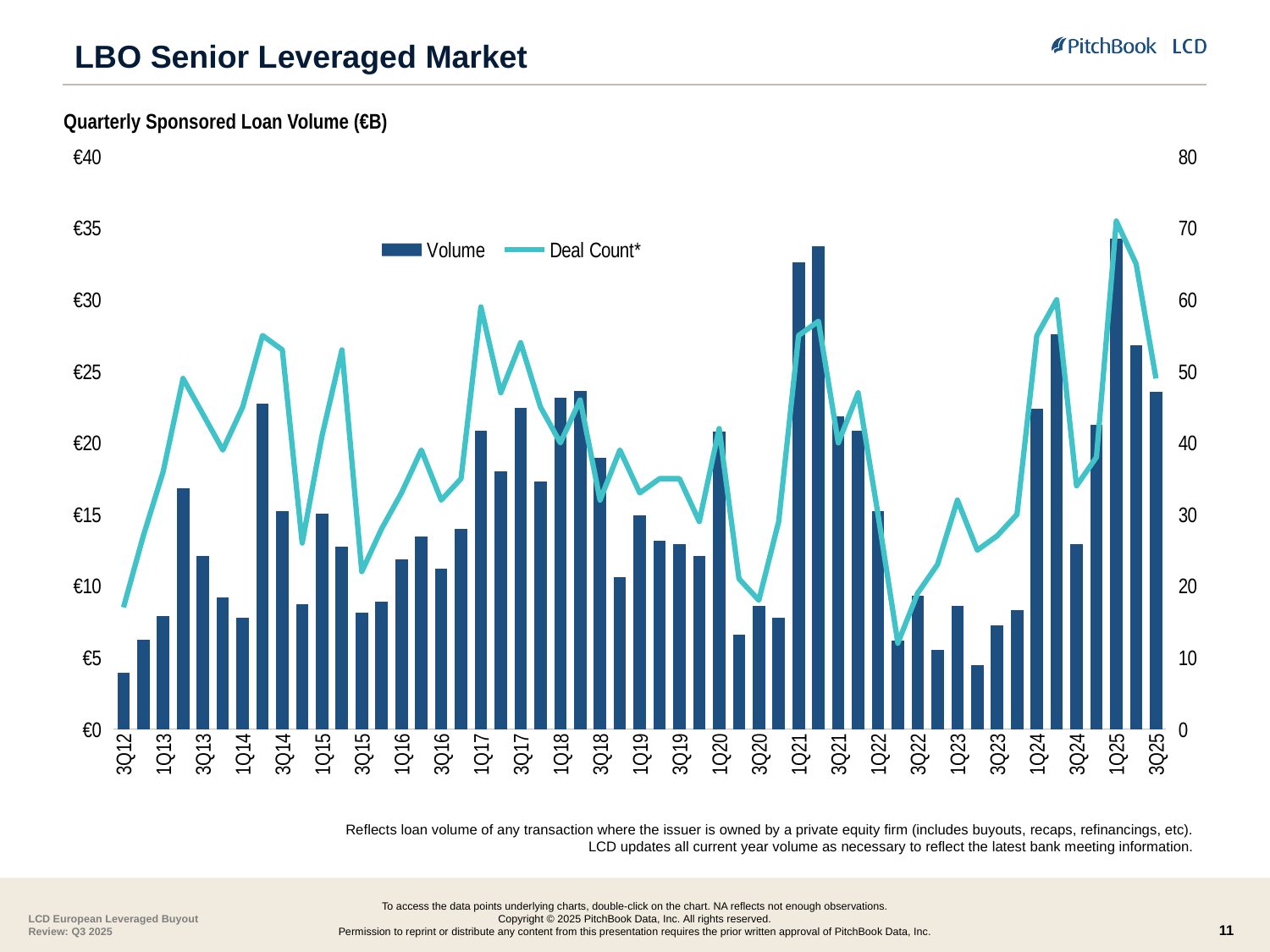
What is the title of the chart? Quarterly Sponsored Loan Volume (€B) Is the Deal Count value for 3Q12 greater or less than 20? less What kind of chart is used to show the Volume series? Bar chart Is the Volume value for 3Q12 greater or less than €5? less Is the Volume value for 3Q25 greater or less than €20? greater How many series does the chart legend list? 2 Which quarter has the larger Volume, 1Q21 or 1Q13? 1Q21 Which quarter has the larger Volume, 1Q24 or 3Q24? 1Q24